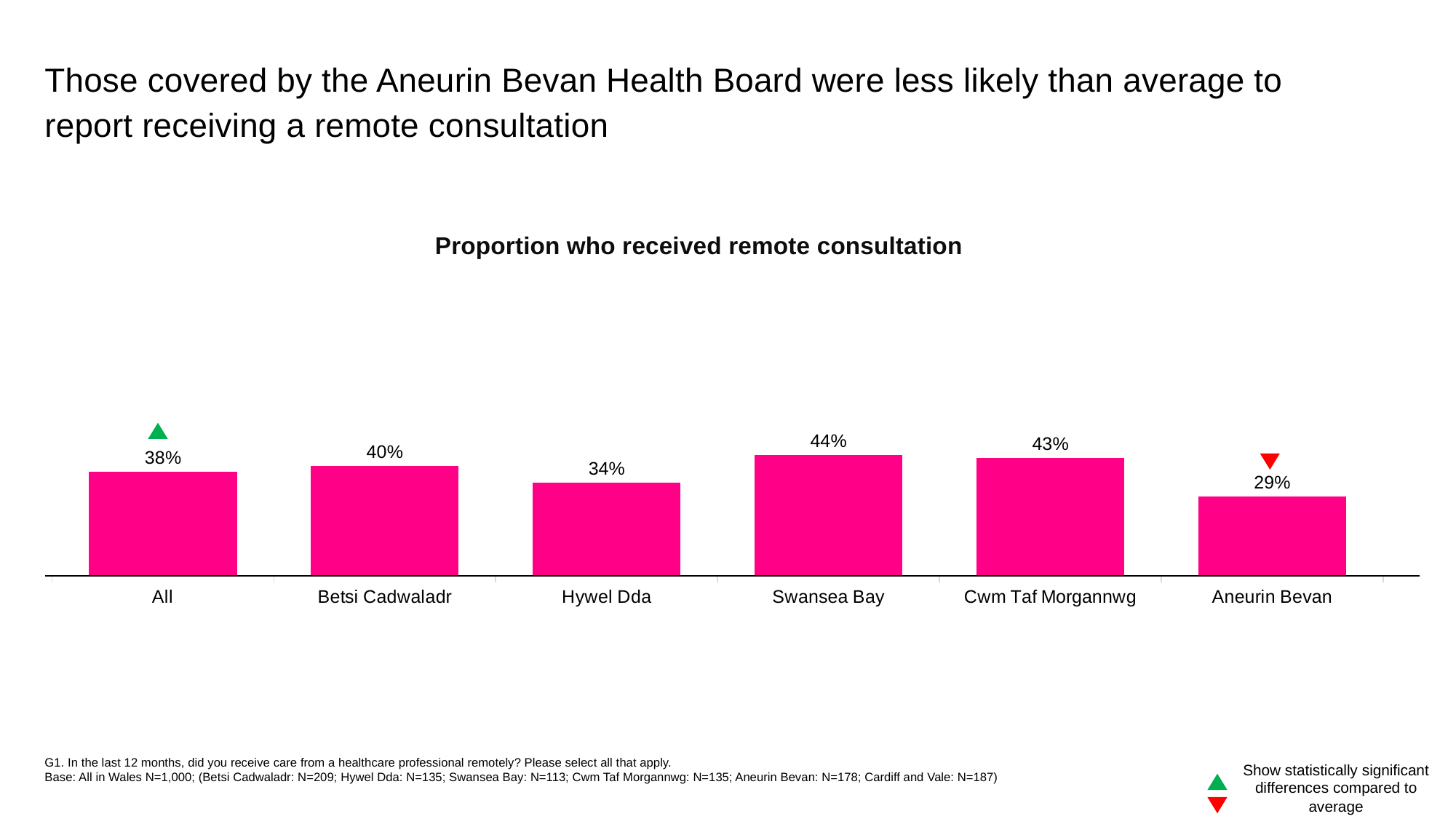
What kind of chart is shown on the slide? Bar chart Which category has the highest value? Swansea Bay How many categories are shown on the x axis? 6 What is the difference between the values for Betsi Cadwaladr and Hywel Dda? 6% What is the value for Betsi Cadwaladr? 40% Which is larger, the value for Hywel Dda or the value for Cwm Taf Morgannwg? Cwm Taf Morgannwg Which category is marked with a red downward triangle? Aneurin Bevan Which category has the lowest value? Aneurin Bevan What is the title of the chart? Proportion who received remote consultation What is the value for Aneurin Bevan? 29% What is the value for All? 38% What is the difference between the values for Swansea Bay and Aneurin Bevan? 15%